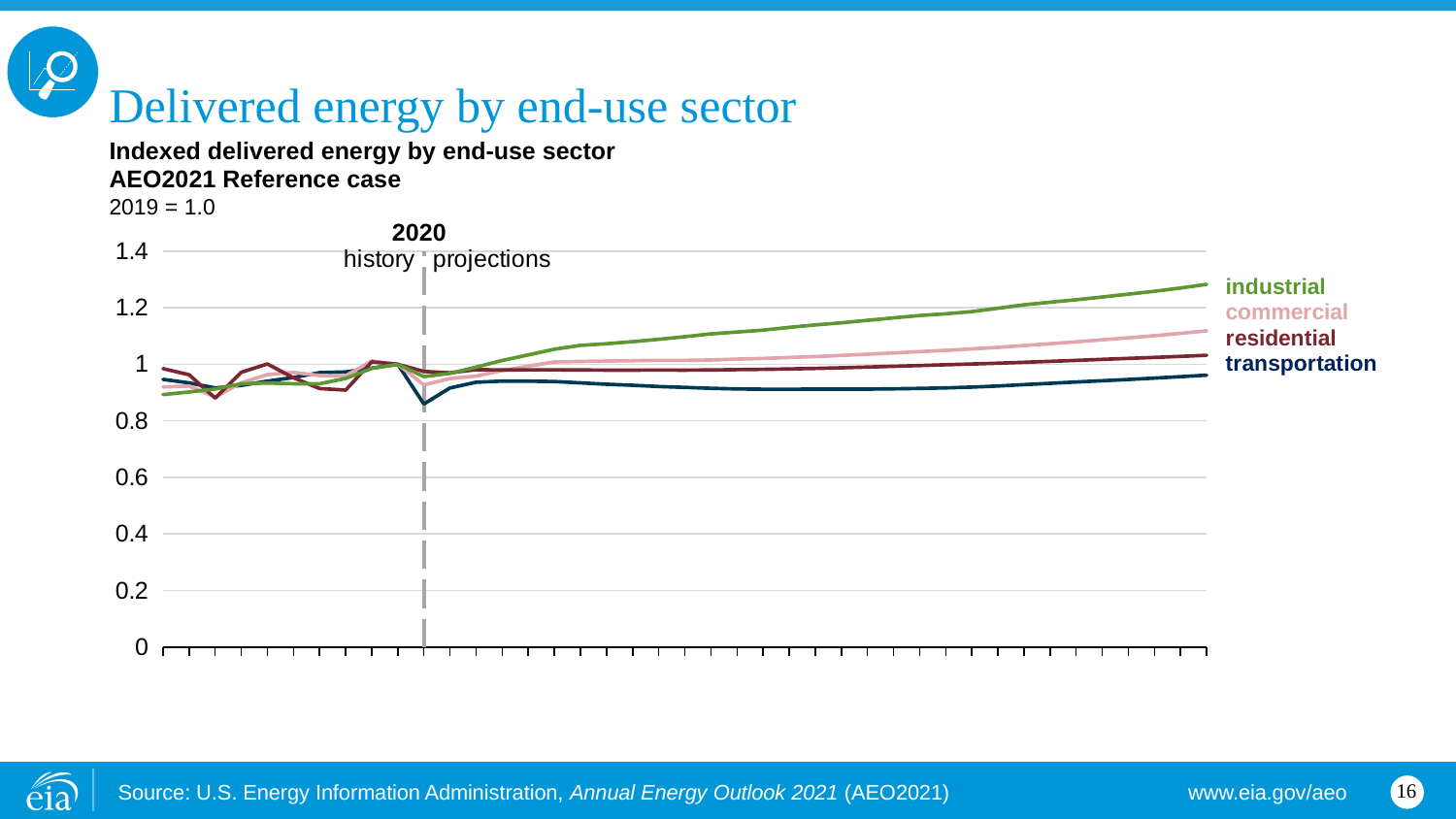
How many series (end-use sectors) are plotted on the chart? 4 Which year is used as the index base (equal to 1.0) in this chart? 2019 At the end of the projection period, is the value for commercial greater or less than 1? greater What kind of chart is shown on the slide? line chart At the end of the projection period, is the value for transportation greater or less than 1? less Which year does the dashed vertical line separating history from projections mark? 2020 At the end of the projection period, which is higher: commercial or residential? commercial Which end-use sector has the lowest indexed delivered energy at the end of the projection period? transportation Does the industrial line rise or fall over the projection period? rise At the end of the projection period, is the value for industrial greater or less than 1.2? greater Which end-use sector has the highest indexed delivered energy at the end of the projection period? industrial